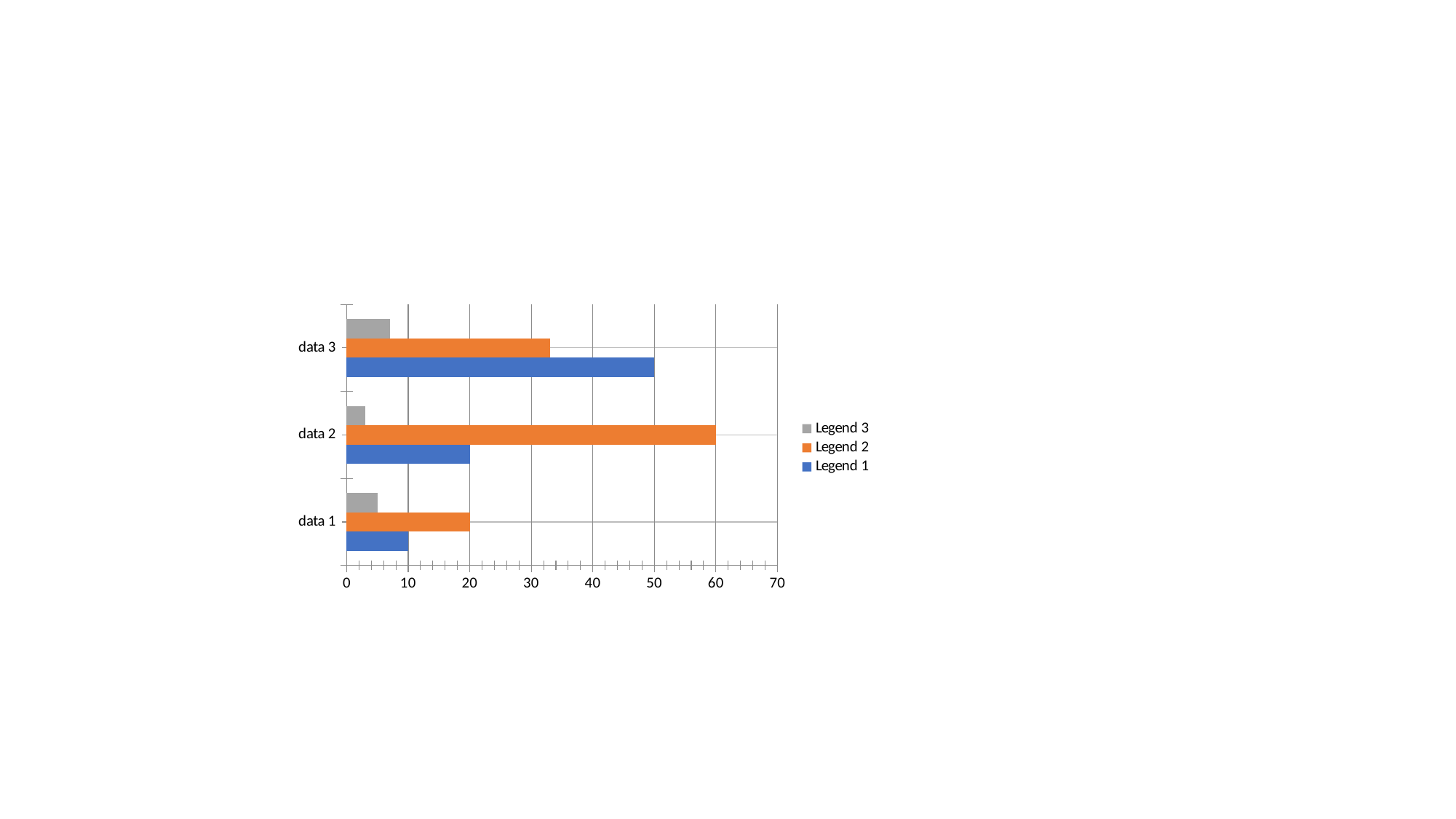
Which category has the highest value for Legend 2? data 2 Is the value of Legend 2 for data 3 greater or less than 40? less How many series does the legend list? 3 What is the value of Legend 2 for data 2? 60 How many categories are shown on the vertical axis? 3 Which category has the highest value for Legend 1? data 3 What is the difference between the Legend 1 values for data 3 and data 1? 40 What is the value of Legend 1 for data 3? 50 What is the value of Legend 2 for data 1? 20 What kind of chart is shown on the slide? bar chart What is the value of Legend 1 for data 1? 10 For data 2, which is larger: Legend 1 or Legend 2? Legend 2